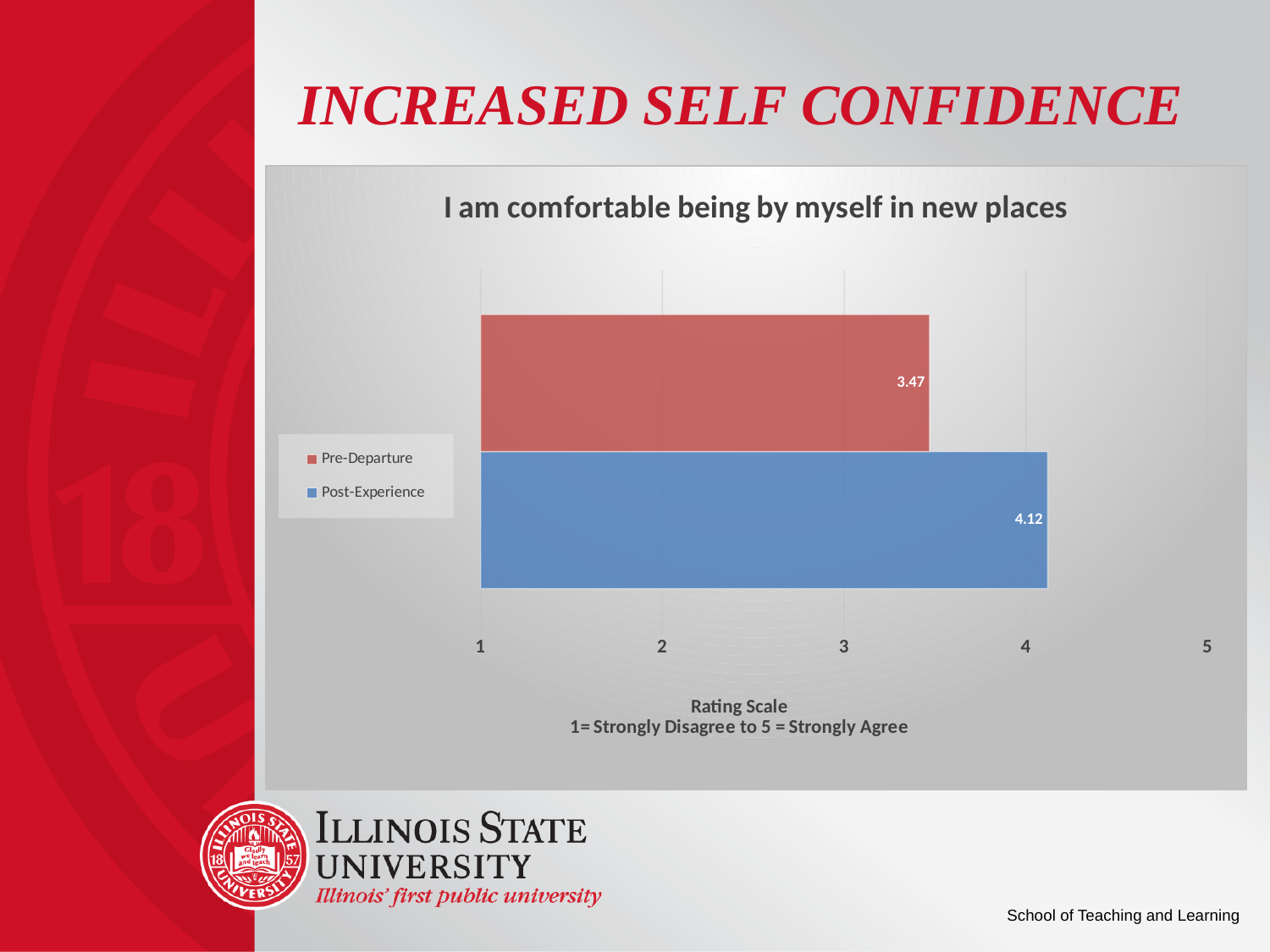
What colour is the Post-Experience bar? blue What is the maximum value shown on the rating scale axis? 5 What is the difference between the Post-Experience and Pre-Departure values? 0.65 How many series does the legend list? 2 What is the value for Post-Experience? 4.12 Which series has the lowest value? Pre-Departure Is the value for Post-Experience greater or less than 4? greater What is the value for Pre-Departure? 3.47 What kind of chart is shown on the slide? bar chart What is the title of the chart? I am comfortable being by myself in new places Is the value for Pre-Departure greater or less than 4? less Which series has the higher value, Pre-Departure or Post-Experience? Post-Experience